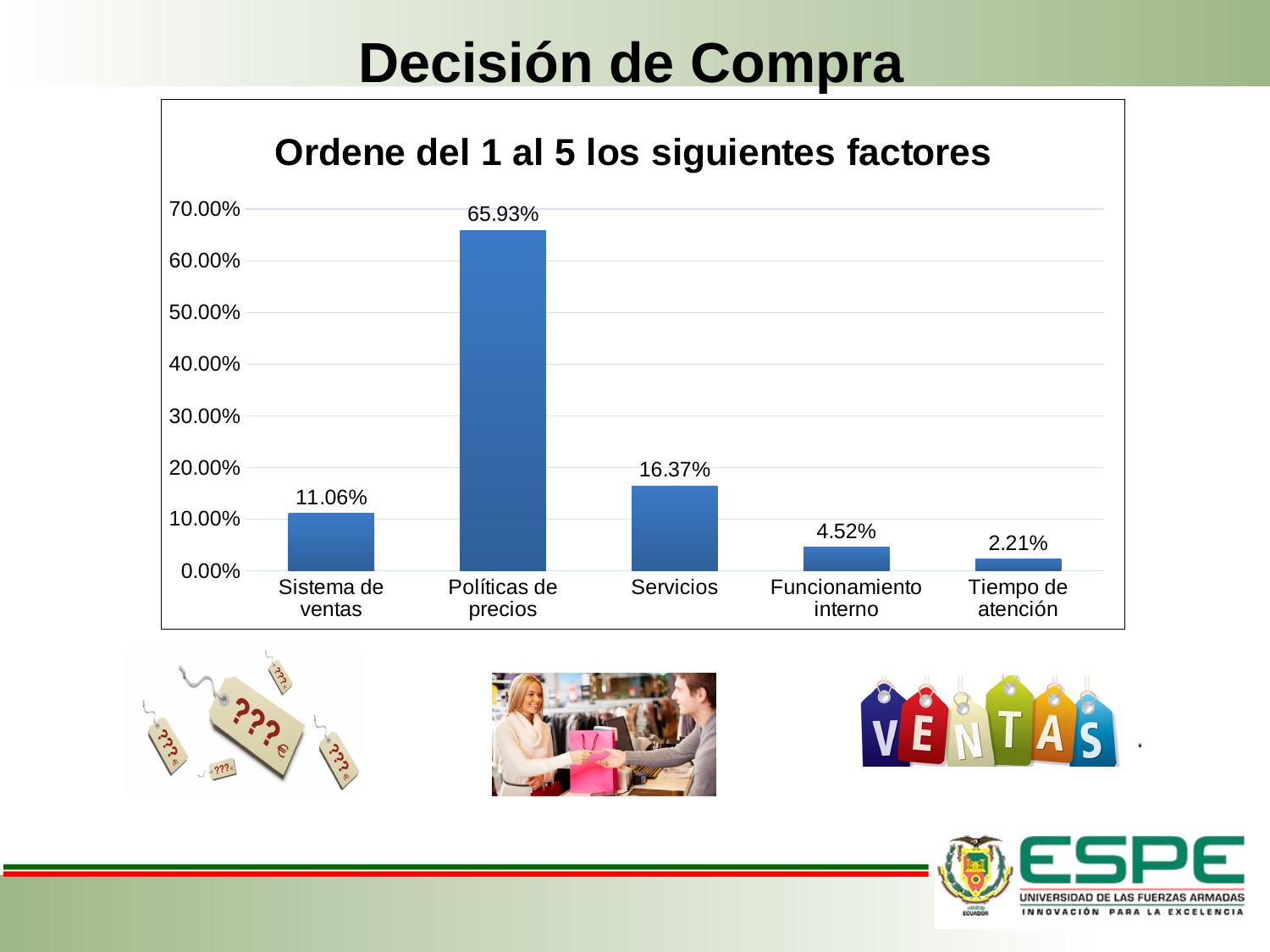
What kind of chart is shown on the slide? bar chart What is the value for Tiempo de atención? 2.21% What is the value for Políticas de precios? 65.93% What is the difference between the values for Funcionamiento interno and Tiempo de atención? 2.31% What is the value for Sistema de ventas? 11.06% Is the value for Servicios greater or less than 20.00%? less How many categories are shown on the x axis? 5 What is the difference between the values for Políticas de precios and Servicios? 49.56% What is the title of the chart? Ordene del 1 al 5 los siguientes factores Which category has the highest value? Políticas de precios Which category has the lowest value? Tiempo de atención Which is larger, the value for Servicios or the value for Sistema de ventas? Servicios